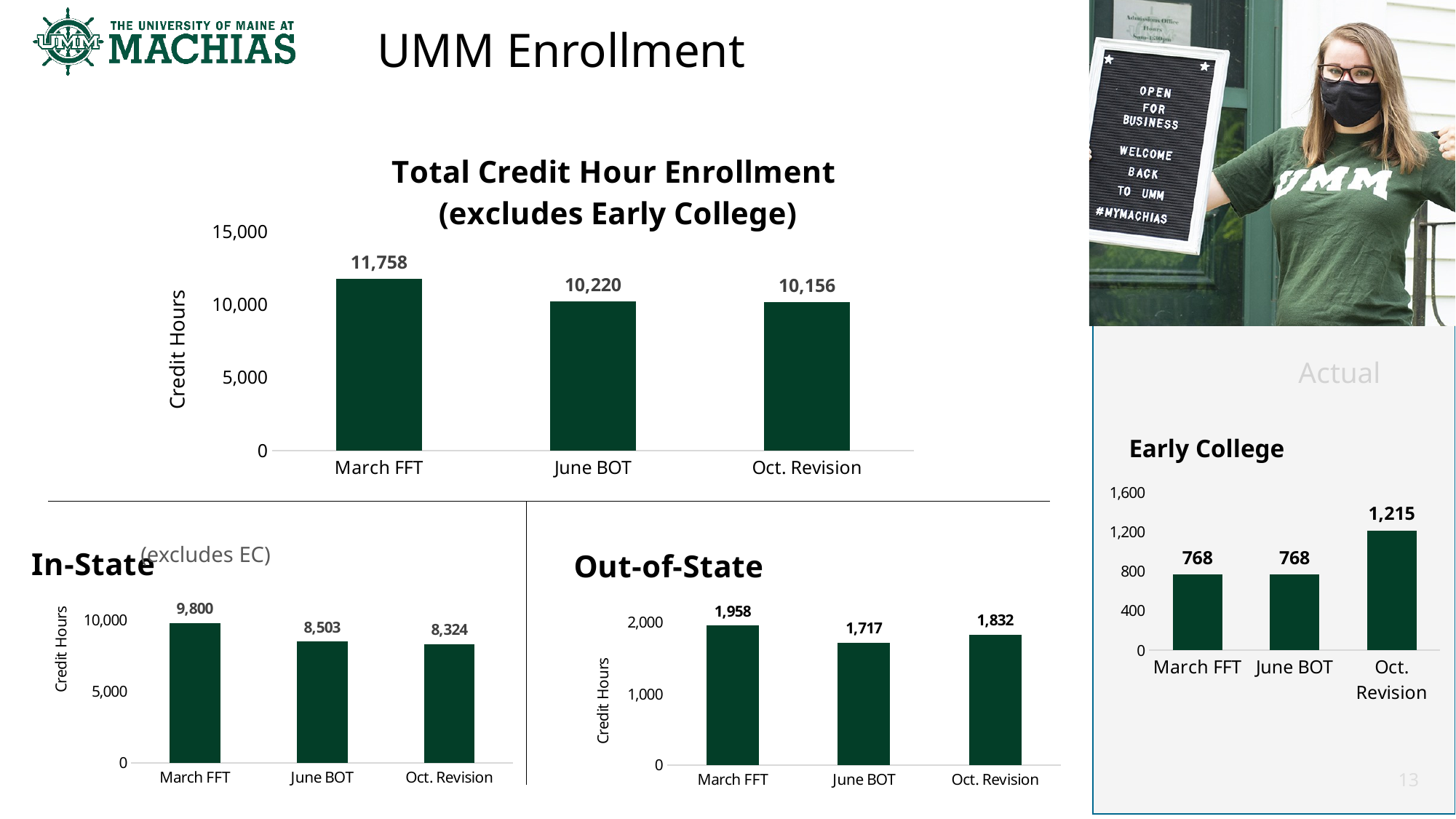
In the Out-of-State chart, which is larger, June BOT or Oct. Revision? Oct. Revision How many categories are shown in the Out-of-State chart? 3 In the Early College chart, what is the difference between Oct. Revision and June BOT? 447 In the Total Credit Hour Enrollment chart, which category has the lowest value? Oct. Revision In the Early College chart, what is the value for Oct. Revision? 1,215 In the Total Credit Hour Enrollment chart, what is the value for March FFT? 11,758 In the Total Credit Hour Enrollment chart, what is the difference between March FFT and June BOT? 1,538 In the In-State chart, what is the value for June BOT? 8,503 In the Early College chart, is the value for March FFT greater or less than 800? less In the Out-of-State chart, what is the value for Oct. Revision? 1,832 What type of chart is the Total Credit Hour Enrollment chart? Bar chart In the In-State chart, which category has the highest value? March FFT